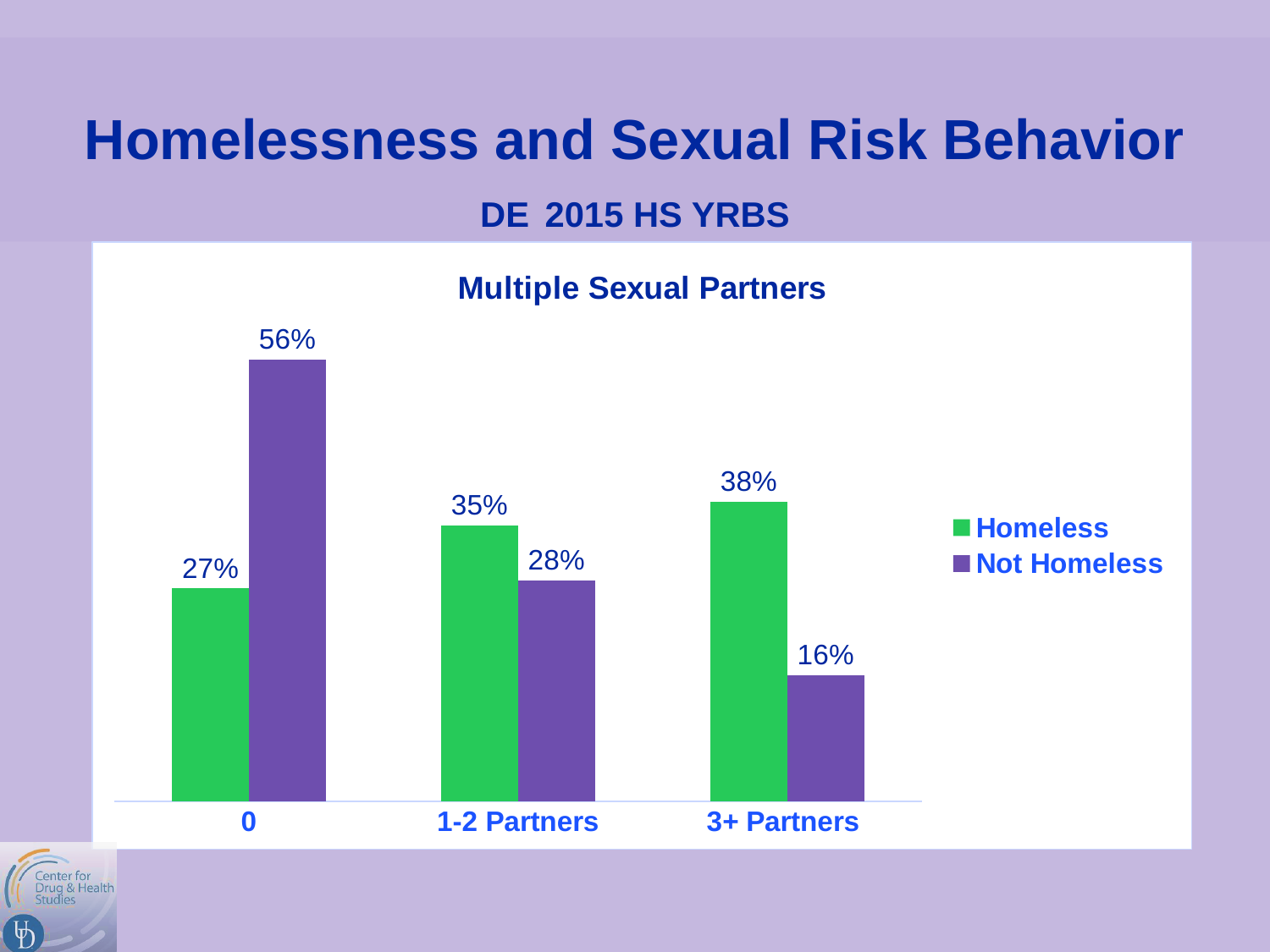
What is the difference between the Not Homeless and Homeless values in the 0 category? 29% What kind of chart is shown on the slide? Bar chart How many categories are shown on the x axis? 3 What is the title of the chart? Multiple Sexual Partners What is the value for Homeless in the 0 category? 27% Which category has the highest value for Not Homeless? 0 Which category has the lowest value for Homeless? 0 In the 1-2 Partners category, which series has the larger value, Homeless or Not Homeless? Homeless What is the difference between the Homeless and Not Homeless values in the 3+ Partners category? 22% What is the value for Homeless in the 1-2 Partners category? 35% What is the value for Not Homeless in the 3+ Partners category? 16% How many series does the legend list? 2